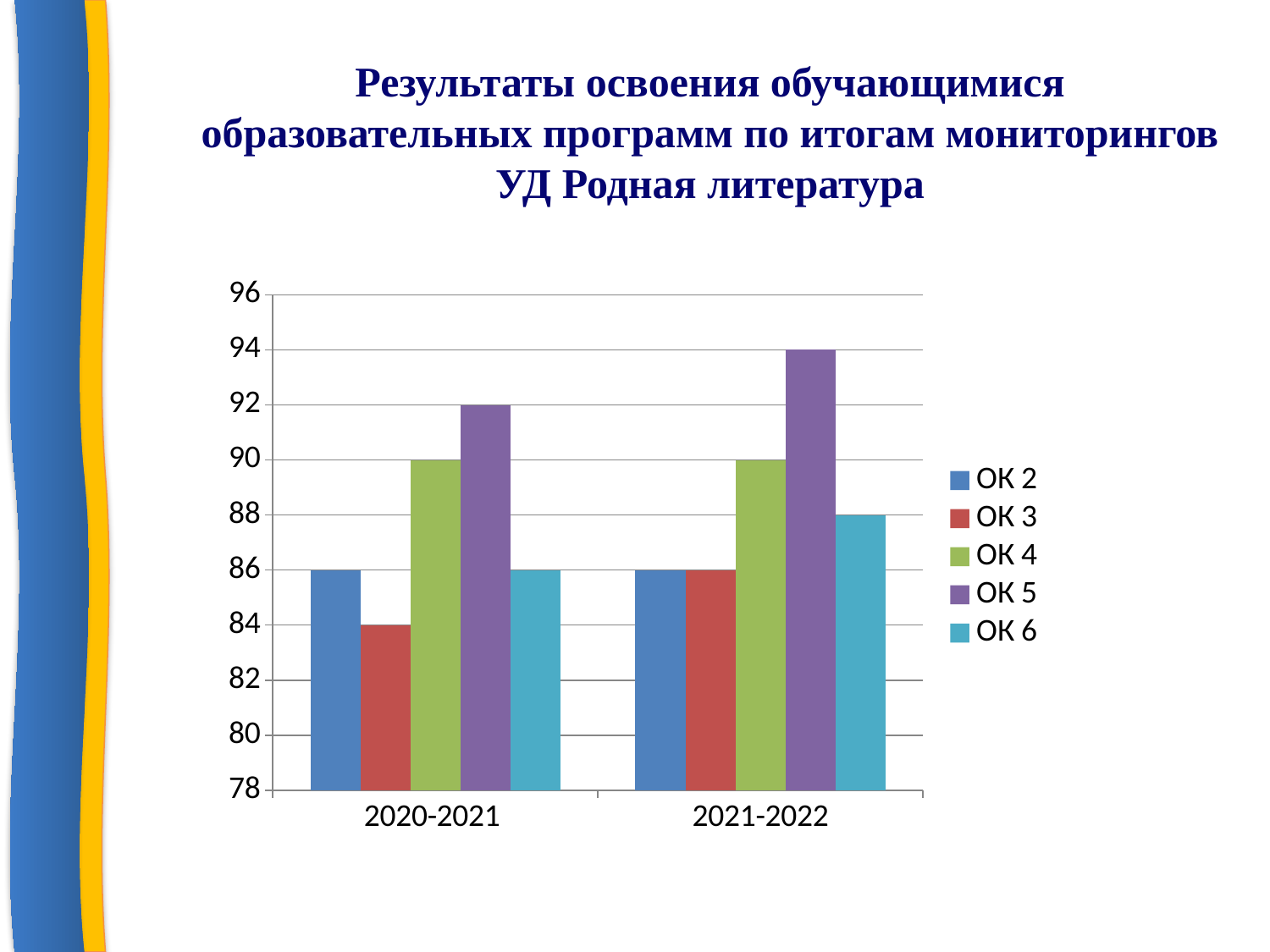
What is the value for ОК 5 in 2020-2021? 92 Which series has the highest value in 2021-2022? ОК 5 What is the difference between the ОК 5 values for 2021-2022 and 2020-2021? 2 Which is larger: ОК 4 in 2020-2021 or ОК 6 in 2020-2021? ОК 4 in 2020-2021 What is the value for ОК 3 in 2020-2021? 84 Does the value for ОК 3 rise or fall from 2020-2021 to 2021-2022? rise How many series does the legend list? 5 What is the value for ОК 6 in 2021-2022? 88 Which series has the lowest value in 2020-2021? ОК 3 How many categories are shown on the x axis? 2 What kind of chart is shown on the slide? bar chart Which series is shown in purple in the legend? ОК 5